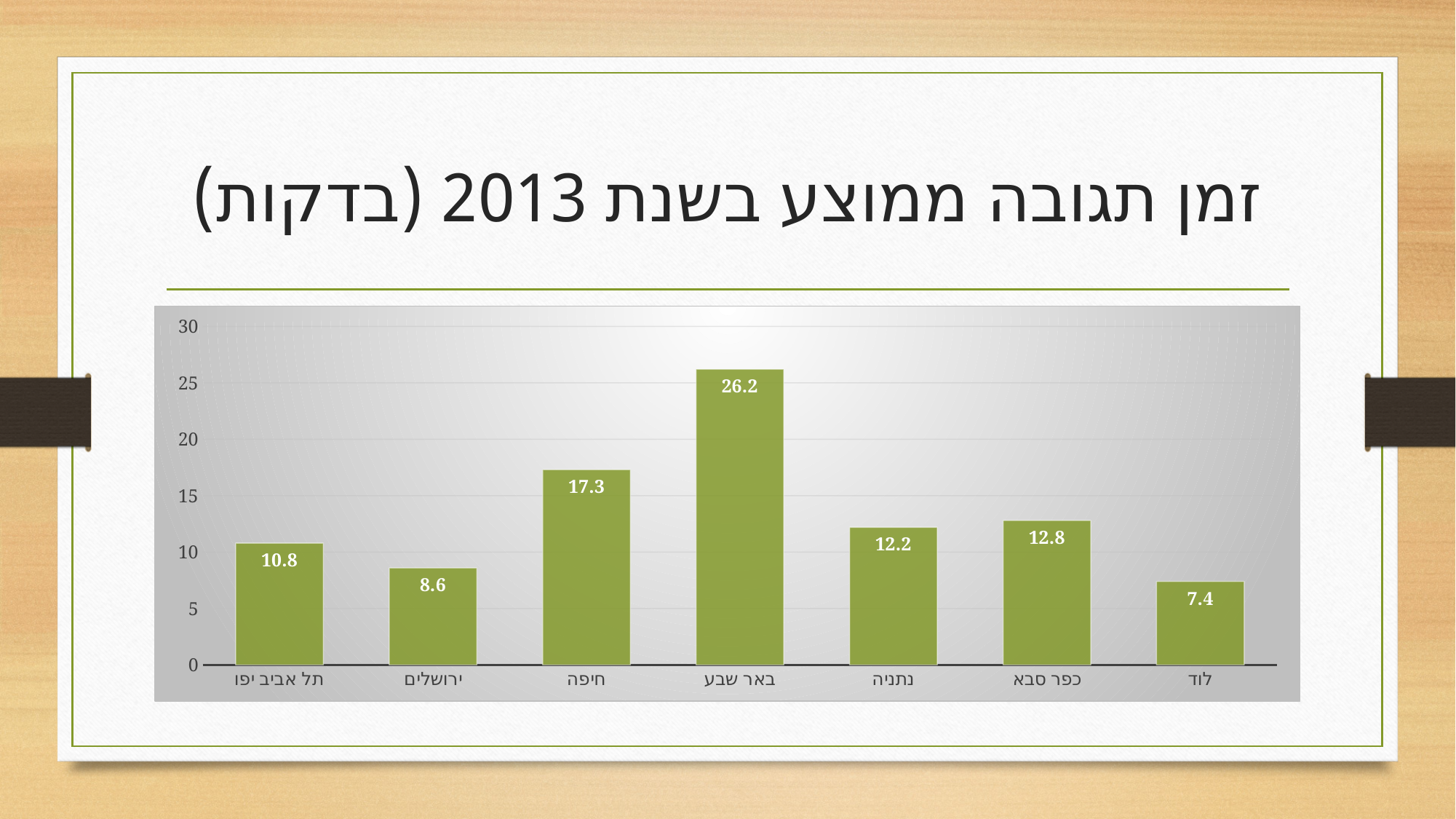
Which is larger, the value for חיפה or the value for נתניה? חיפה Is the value for באר שבע greater or less than 25? greater What is the difference between the values for תל אביב יפו and לוד? 3.4 Which category has the lowest value? לוד What is the value for כפר סבא? 12.8 What kind of chart is shown on the slide? bar chart What is the value for באר שבע? 26.2 What is the difference between the values for באר שבע and חיפה? 8.9 Which category has the highest value? באר שבע What is the title of the slide? זמן תגובה ממוצע בשנת 2013 (בדקות) What is the value for ירושלים? 8.6 How many categories are shown on the x axis? 7